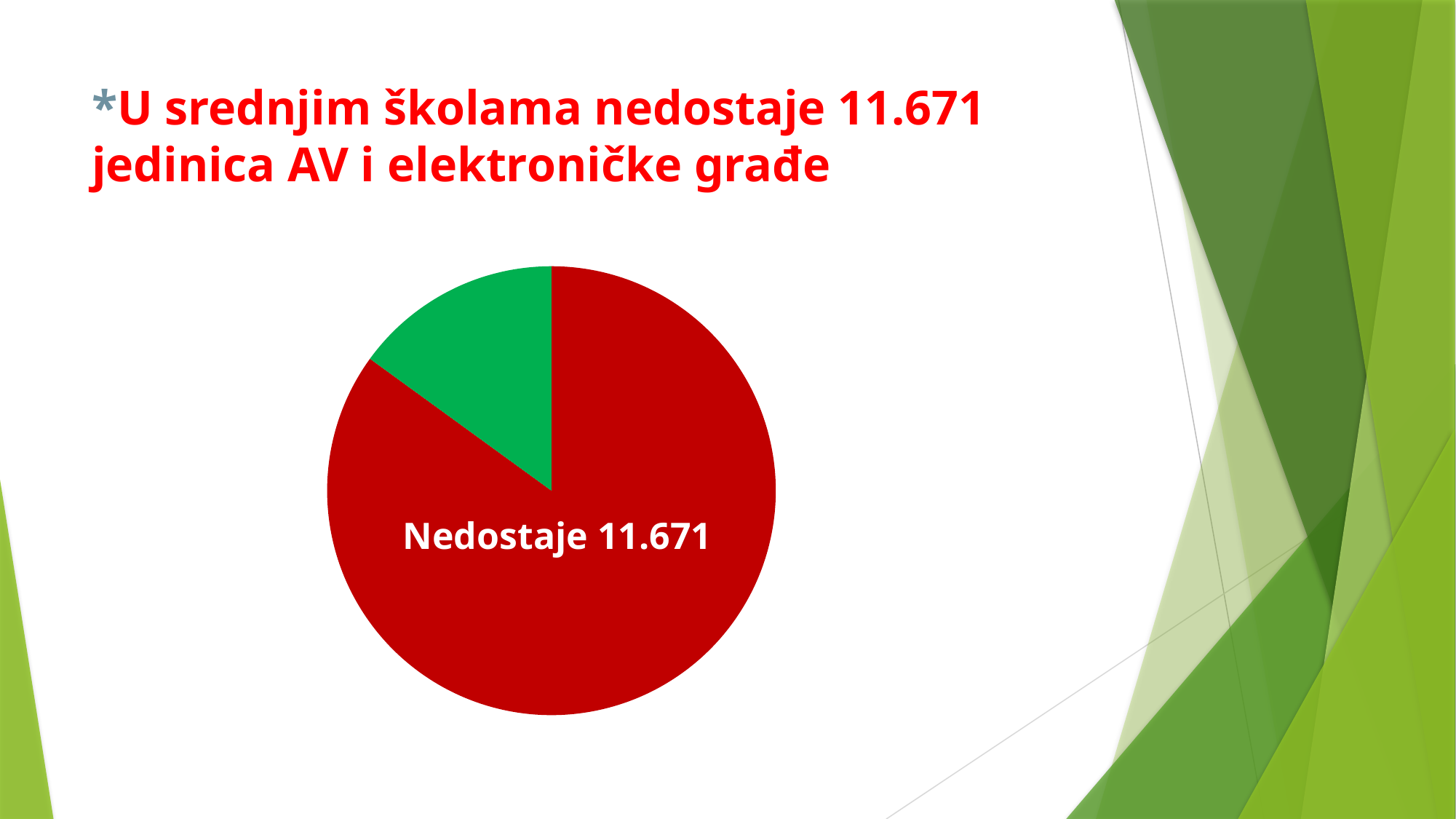
Is the share of the red slice in the pie chart greater or less than half of the pie? greater Which slice is larger, the red slice or the green slice? the red slice Which slice of the pie chart is the largest? Nedostaje 11.671 What value is printed on the red slice of the pie chart? 11.671 What is the label printed on the large red slice of the pie chart? Nedostaje 11.671 What colour is the smaller, unlabelled slice of the pie chart? green How many slices does the pie chart have? 2 What colour is the slice labelled "Nedostaje 11.671"? red What kind of chart is shown on the slide? pie chart